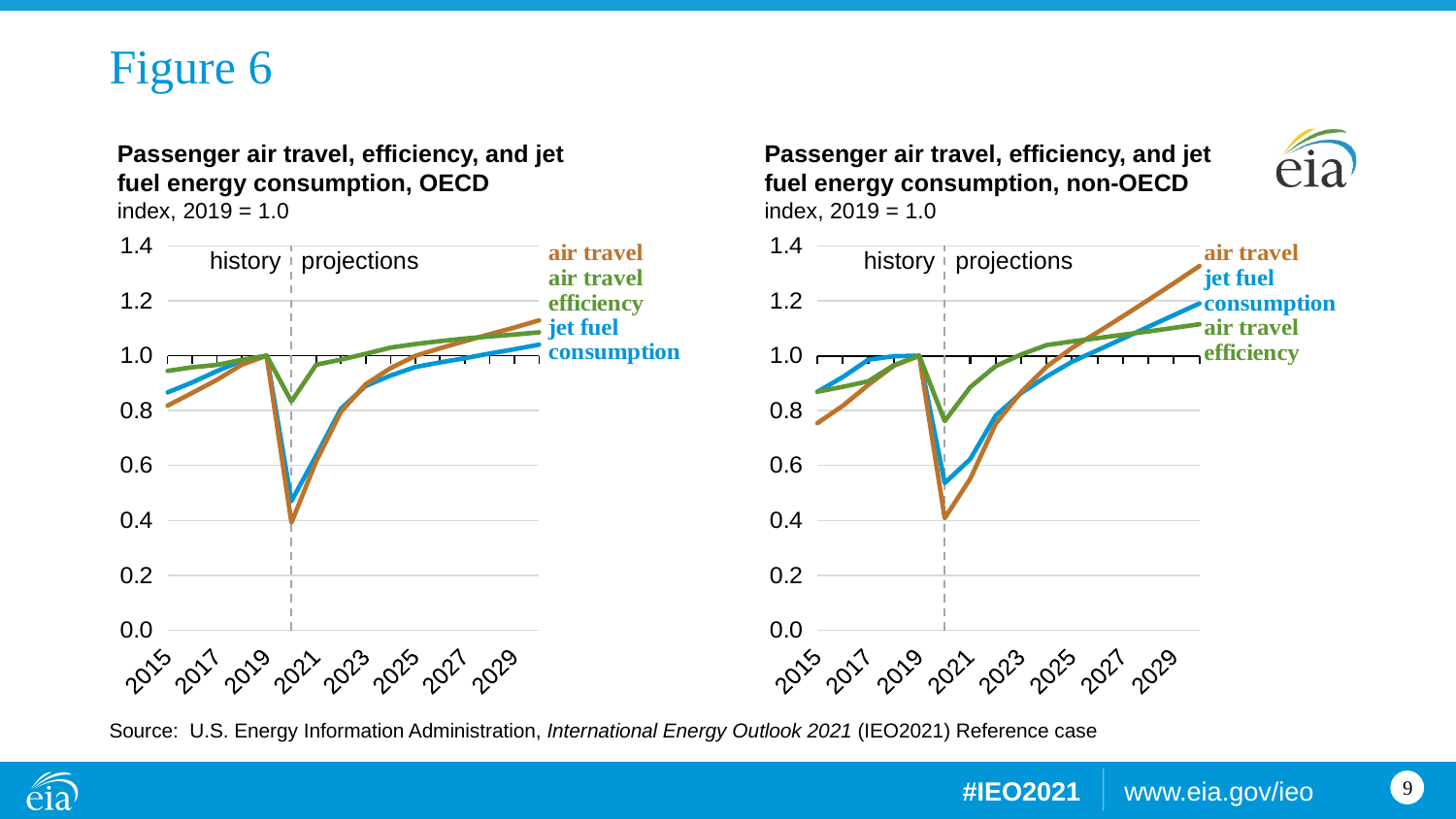
In the OECD chart on the left, which series falls to the lowest value in 2020? air travel What kind of chart is the OECD chart on the left? line chart In the non-OECD chart on the right, is the value for air travel in 2029 greater or less than 1.2? greater In the OECD chart on the left, is the value for air travel in 2020 greater or less than 0.6? less In the non-OECD chart on the right, does air travel rise or fall from 2021 to 2029? rise How many series does the legend of the non-OECD chart on the right list? 3 In the OECD chart on the left, which is larger in 2020: air travel or jet fuel consumption? jet fuel consumption In the OECD chart on the left, what is the index value of all three series in 2019? 1.0 What is the title of the chart on the right? Passenger air travel, efficiency, and jet fuel energy consumption, non-OECD In the OECD chart on the left, is the value for air travel efficiency in 2020 greater or less than 0.6? greater In the non-OECD chart on the right, which series reaches the highest value in 2029? air travel